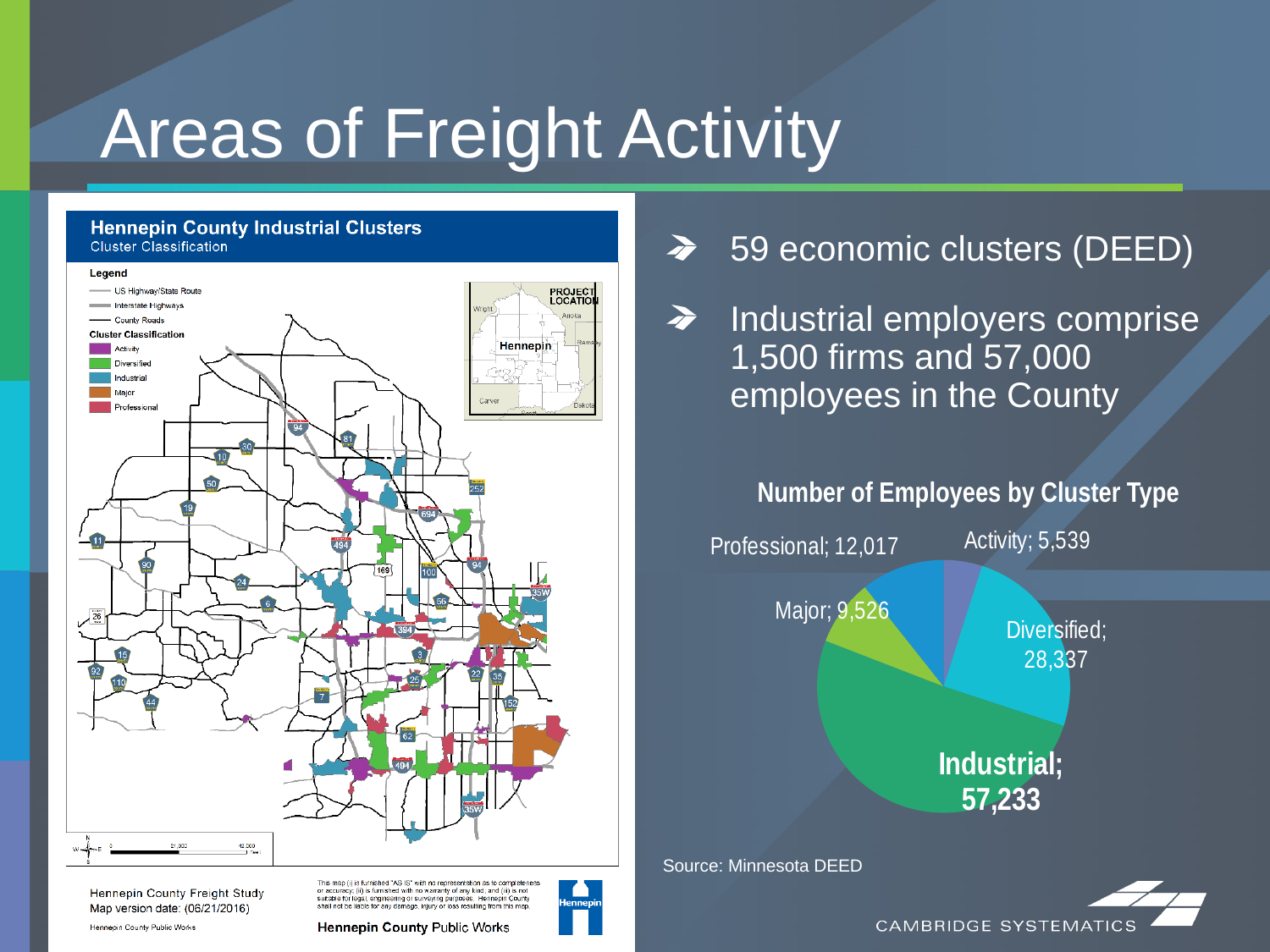
In the 'Number of Employees by Cluster Type' chart, how many employees are in the Industrial cluster type? 57,233 Which cluster type has the fewest employees in the 'Number of Employees by Cluster Type' chart? Activity What is the title of the pie chart on the slide? Number of Employees by Cluster Type In the 'Number of Employees by Cluster Type' chart, what is the value for Activity? 5,539 How many cluster types are shown in the 'Number of Employees by Cluster Type' pie chart? 5 In the 'Number of Employees by Cluster Type' chart, which has more employees, Professional or Major? Professional Which cluster type has the most employees in the 'Number of Employees by Cluster Type' chart? Industrial In the 'Number of Employees by Cluster Type' chart, what is the value for Major? 9,526 In the 'Number of Employees by Cluster Type' chart, how many employees are in the Diversified cluster type? 28,337 In the 'Number of Employees by Cluster Type' chart, what is the value for Professional? 12,017 In the 'Number of Employees by Cluster Type' chart, how many more employees does Industrial have than Diversified? 28,896 What kind of chart is 'Number of Employees by Cluster Type'? pie chart